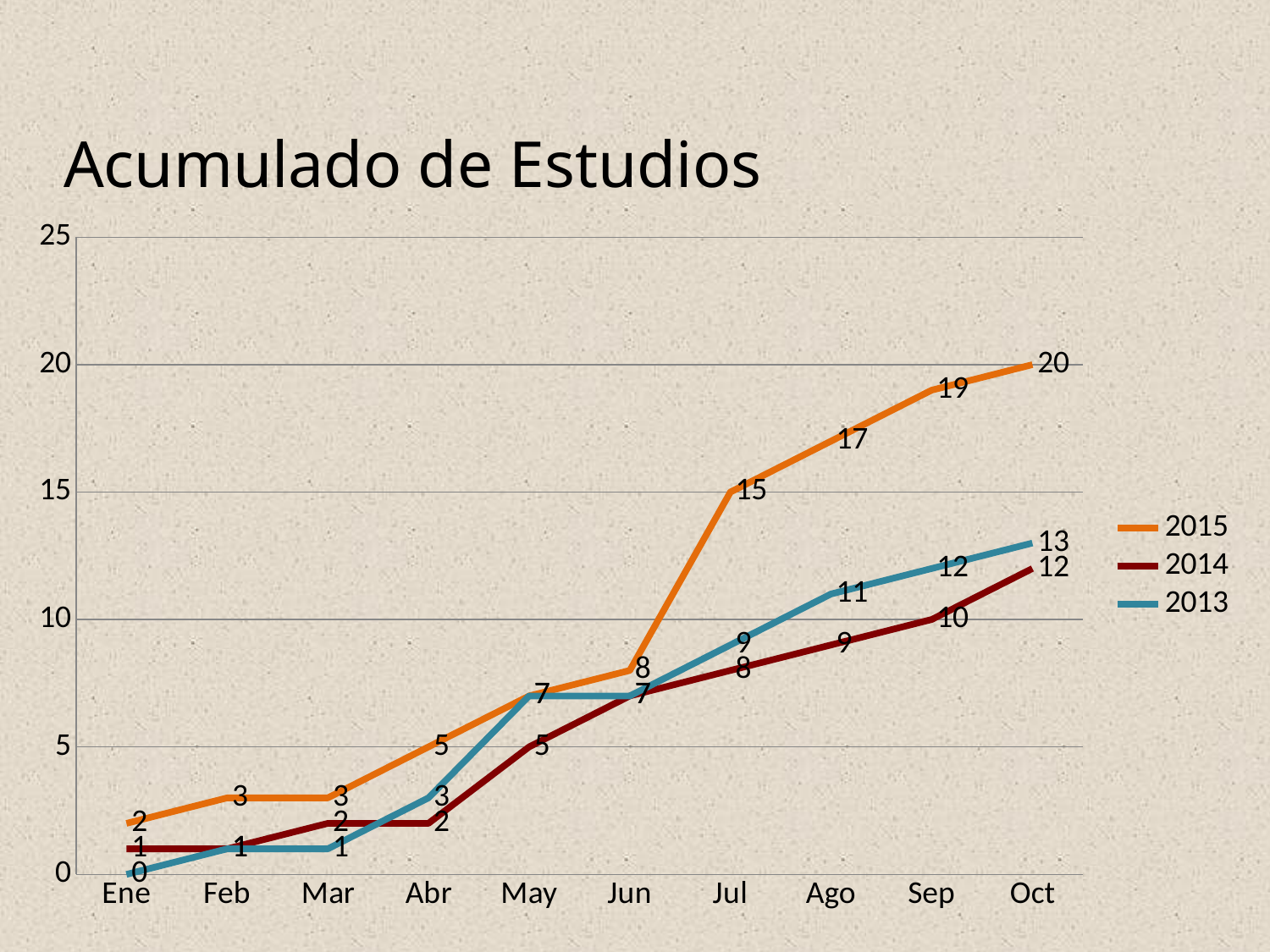
What is the title of the chart? Acumulado de Estudios What is the value for 2014 in Oct? 12 Does the 2015 line rise or fall from Ene to Oct? rise What kind of chart is shown on the slide? line chart What is the value for 2015 in Jul? 15 How many months are shown along the x axis? 10 Which series has the highest value in Oct? 2015 In Ago, which is larger: the value for 2015 or the value for 2013? 2015 What is the difference between the 2015 and 2014 values in Oct? 8 How many series does the legend list? 3 What is the value for 2013 in Oct? 13 What is the value for 2015 in Oct? 20